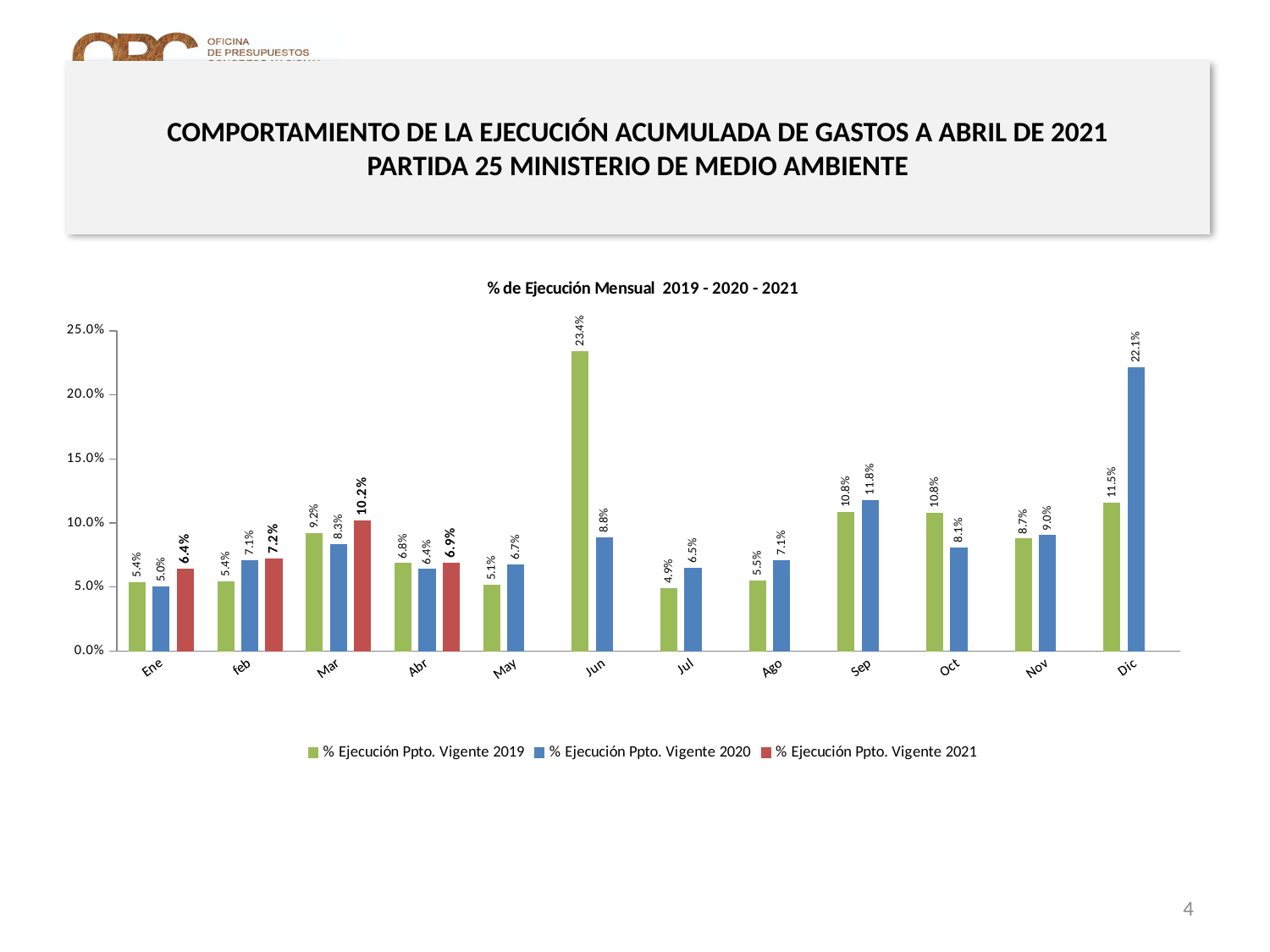
What is the difference between the 2019 and 2020 values in Jun? 14.6% What kind of chart is shown on the slide? Bar chart Which is larger in Oct: the 2019 value or the 2020 value? 2019 (10.8%) Which month has the lowest value for % Ejecución Ppto. Vigente 2020? Ene Is the value for % Ejecución Ppto. Vigente 2020 in Dic greater or less than 20.0%? greater What is the value for % Ejecución Ppto. Vigente 2020 in Dic? 22.1% How many series does the legend list? 3 What is the value for % Ejecución Ppto. Vigente 2021 in Mar? 10.2% Which month has the highest value for % Ejecución Ppto. Vigente 2019? Jun How many months are shown on the x axis? 12 What is the value for % Ejecución Ppto. Vigente 2019 in Jun? 23.4% What is the value for % Ejecución Ppto. Vigente 2020 in Sep? 11.8%